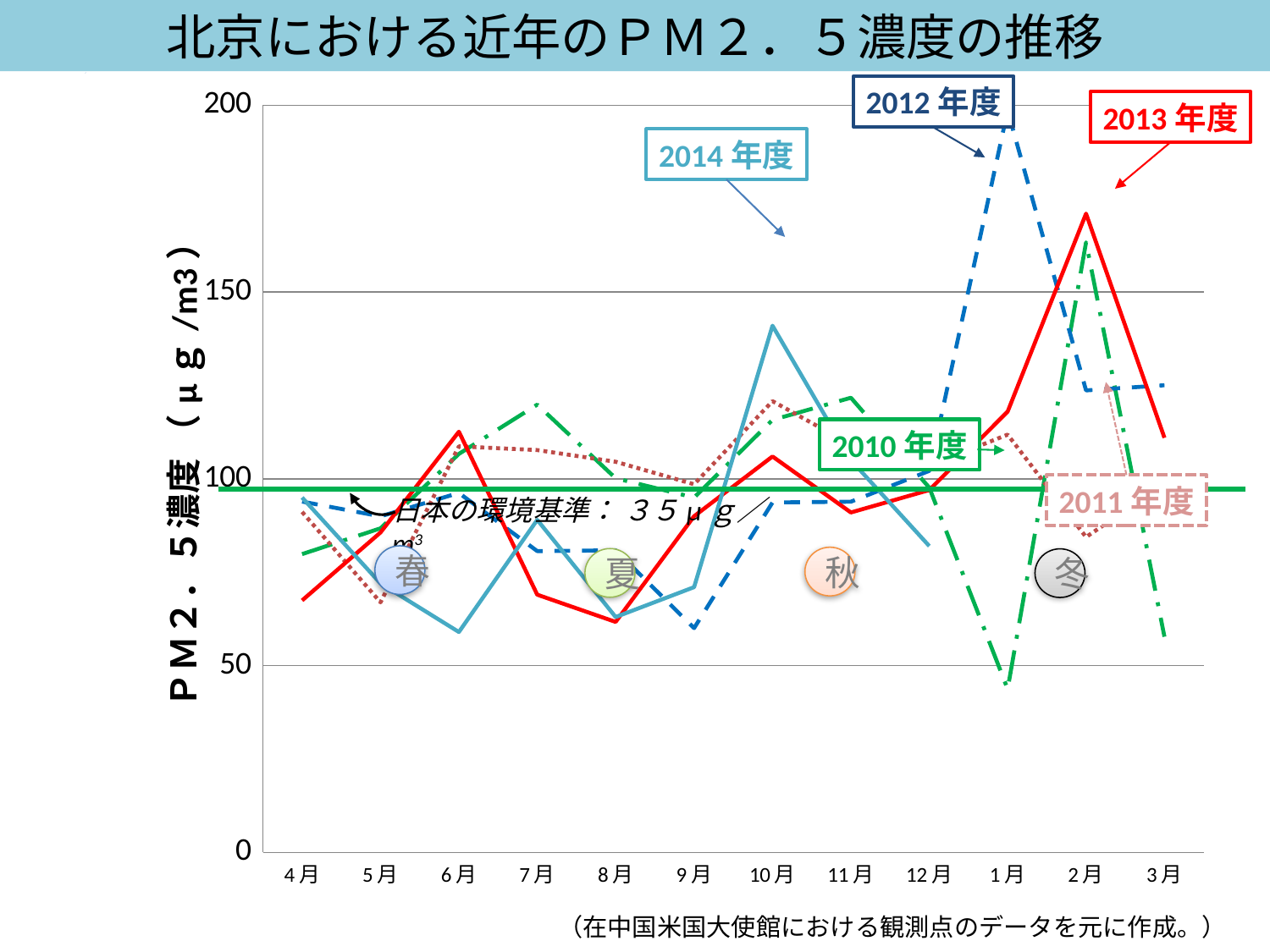
How many months are shown along the x axis? 12 In which month does the 2010年度 series reach its lowest value? 1月 How many fiscal-year series (年度) are labelled on the chart? 5 What is the title of the chart? 北京における近年のＰＭ２．５濃度の推移 Is the 2014年度 value for 6月 greater or less than 100? less In which month does the 2012年度 series reach its highest value? 1月 Does the 2013年度 series rise or fall from 12月 to 2月? rise In which month does the 2013年度 series reach its highest value? 2月 In which month does the 2014年度 series reach its highest value? 10月 What kind of chart is shown on the slide? line chart Is the 2012年度 value for 1月 greater or less than 150? greater Which is larger in 2月: the 2013年度 value or the 2012年度 value? 2013年度